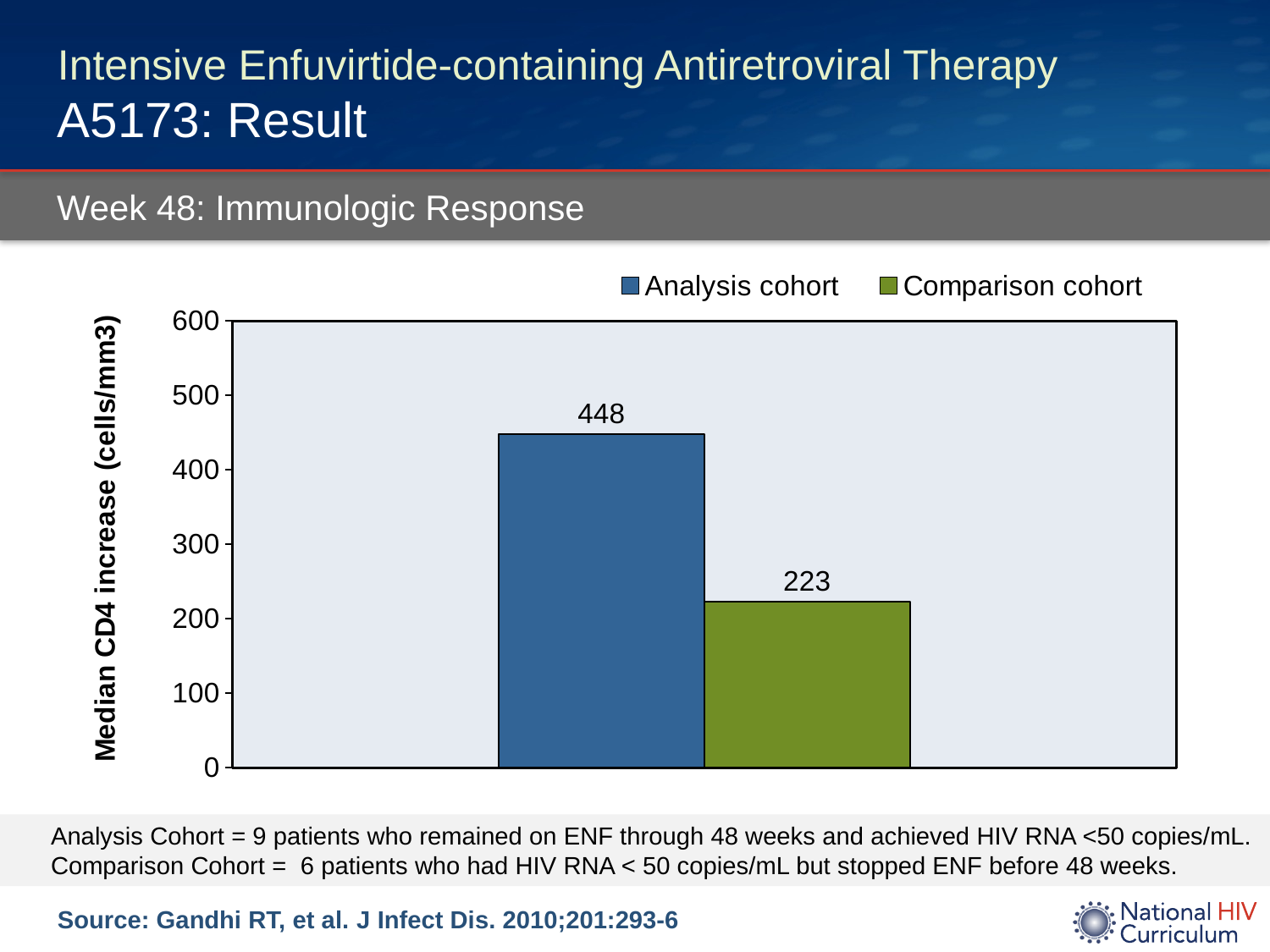
What is the maximum value shown on the y axis? 600 How many series does the legend list? 2 What is the difference in median CD4 increase between the Analysis cohort and the Comparison cohort? 225 What kind of chart is shown on the slide? Bar chart What is the label of the y axis? Median CD4 increase (cells/mm3) What is the median CD4 increase for the Comparison cohort? 223 What is the median CD4 increase for the Analysis cohort? 448 Is the median CD4 increase larger for the Analysis cohort or the Comparison cohort? Analysis cohort Is the value for the Analysis cohort greater or less than 400? greater Is the value for the Comparison cohort greater or less than 300? less Which cohort has the higher median CD4 increase? Analysis cohort Which cohort has the lower median CD4 increase? Comparison cohort